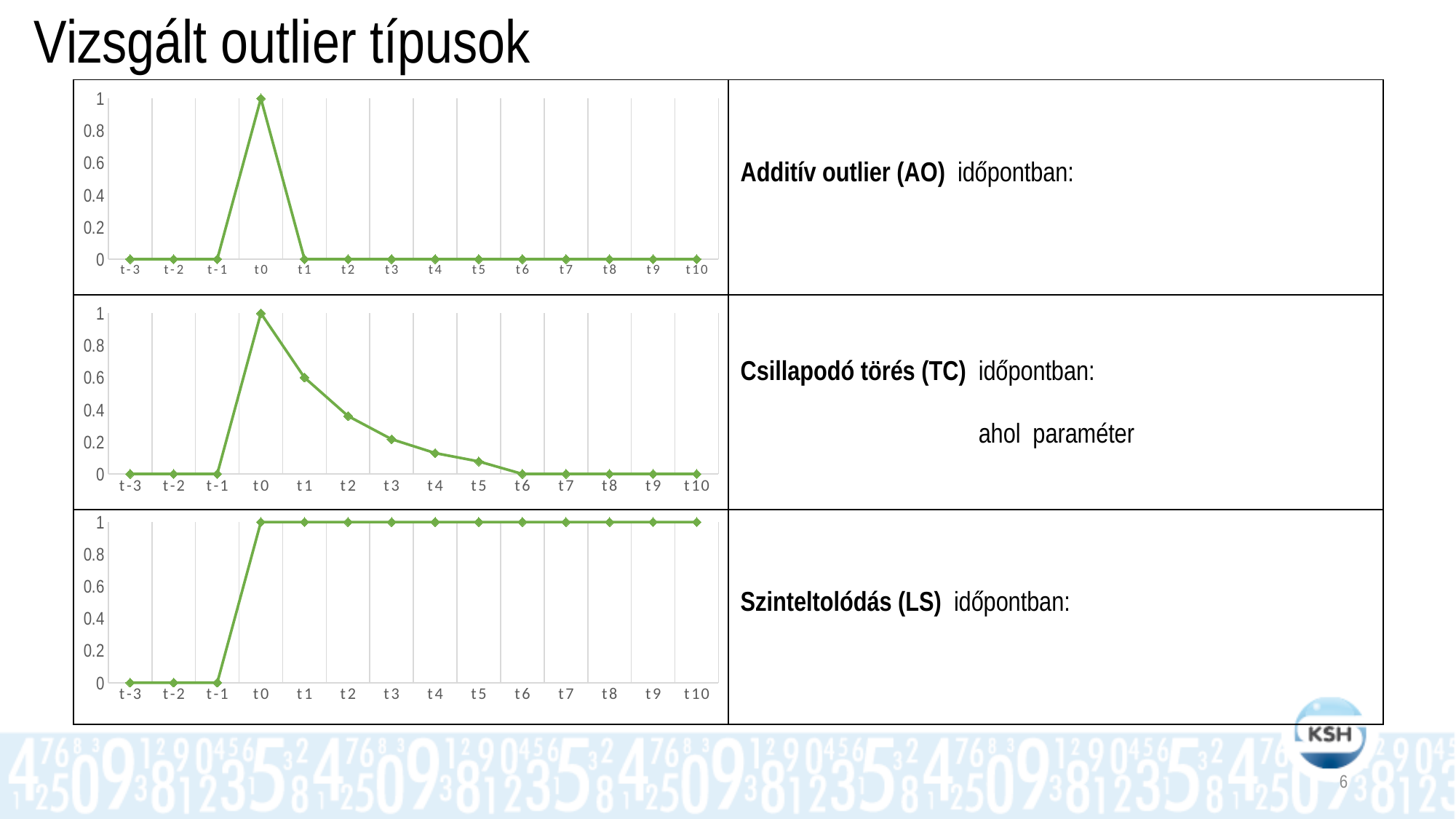
What kind of chart is the top chart on the slide? line chart How many time points are shown on the x axis of the top chart? 14 In the bottom chart, which is larger, the value at t-2 or the value at t5? t5 In the middle chart, what is the value at t0? 1 In the bottom chart, what is the value at t-1? 0 In the top chart, at which time point is the value highest? t0 In the middle chart, do the values rise or fall from t0 to t6? fall In the top chart, what is the value at t1? 0 In the bottom chart, what is the value at t10? 1 In the middle chart, is the value at t3 greater or less than 0.4? less In the top chart, what is the value at t0? 1 In the middle chart, is the value at t1 greater or less than 0.4? greater